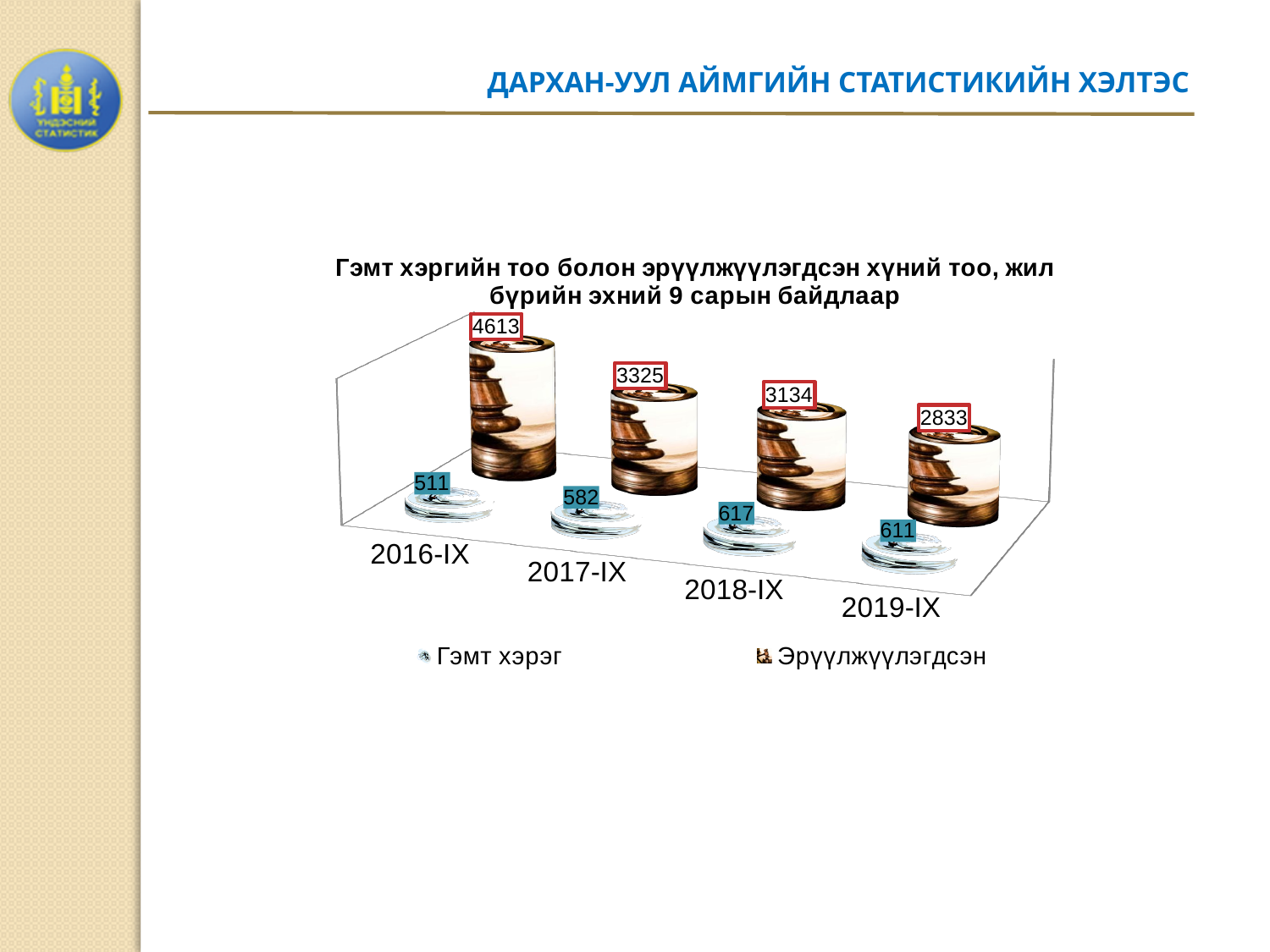
What is the value of Гэмт хэрэг for 2018-IX? 617 What is the value of Эрүүлжүүлэгдсэн for 2016-IX? 4613 In which period is Гэмт хэрэг lowest? 2016-IX What is the value of Эрүүлжүүлэгдсэн for 2019-IX? 2833 How many periods are shown on the x axis? 4 How many series does the legend list? 2 What is the difference between Эрүүлжүүлэгдсэн in 2016-IX and 2017-IX? 1288 Which is larger: Гэмт хэрэг in 2018-IX or in 2019-IX? 2018-IX In which period is Эрүүлжүүлэгдсэн highest? 2016-IX What kind of chart is shown? bar chart Does Эрүүлжүүлэгдсэн rise or fall from 2016-IX to 2019-IX? fall What is the value of Гэмт хэрэг for 2017-IX? 582